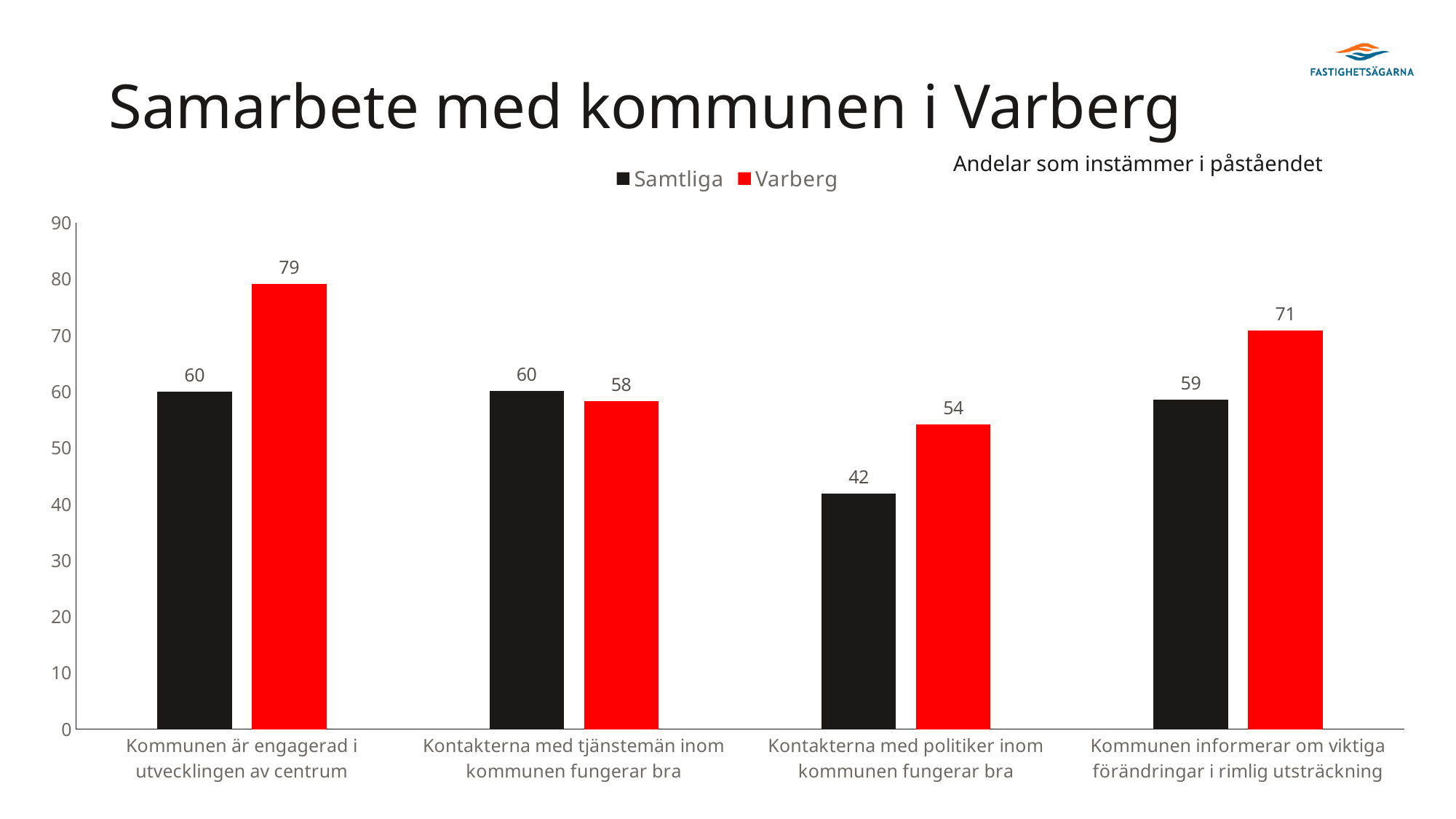
What colour are the Varberg bars? Red How many categories are shown on the x axis? 4 What kind of chart is shown on the slide? Bar chart How many series does the legend list? 2 Which category has the highest Varberg value? Kommunen är engagerad i utvecklingen av centrum Which category has the lowest Samtliga value? Kontakterna med politiker inom kommunen fungerar bra For "Kontakterna med tjänstemän inom kommunen fungerar bra", which series has the larger value, Samtliga or Varberg? Samtliga What is the Varberg value for "Kommunen är engagerad i utvecklingen av centrum"? 79 What is the difference between the Varberg and Samtliga values for "Kommunen är engagerad i utvecklingen av centrum"? 19 What is the Samtliga value for "Kontakterna med politiker inom kommunen fungerar bra"? 42 Is the Varberg value for "Kontakterna med politiker inom kommunen fungerar bra" greater or less than 50? greater What is the Varberg value for "Kommunen informerar om viktiga förändringar i rimlig utsträckning"? 71